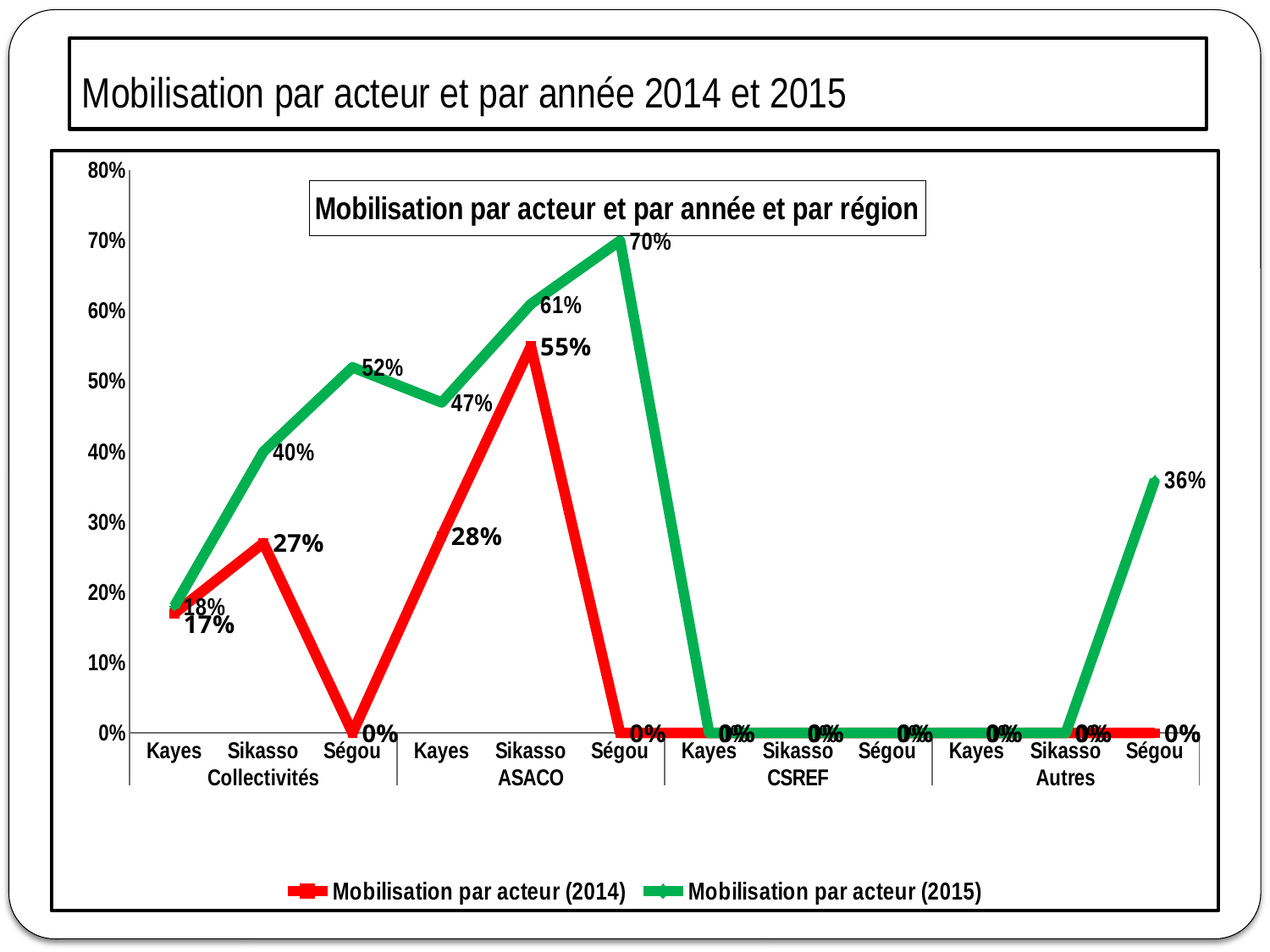
Which point has the highest value for the Mobilisation par acteur (2015) series? Ségou (ASACO) How many series does the legend list? 2 What is the 2015 mobilisation value for Ségou under ASACO? 70% What is the 2014 mobilisation value for Sikasso under ASACO? 55% How many actor groups are shown along the x axis? 4 What is the difference between the 2015 and 2014 values for Sikasso under Collectivités? 13% What is the 2015 mobilisation value for Ségou under Autres? 36% Which point has the highest value for the Mobilisation par acteur (2014) series? Sikasso (ASACO) What is the 2014 mobilisation value for Kayes under Collectivités? 17% What is the title printed inside the chart area? Mobilisation par acteur et par année et par région What type of chart is shown on the slide? Line chart For Kayes under ASACO, which series has the larger value, 2014 or 2015? Mobilisation par acteur (2015)